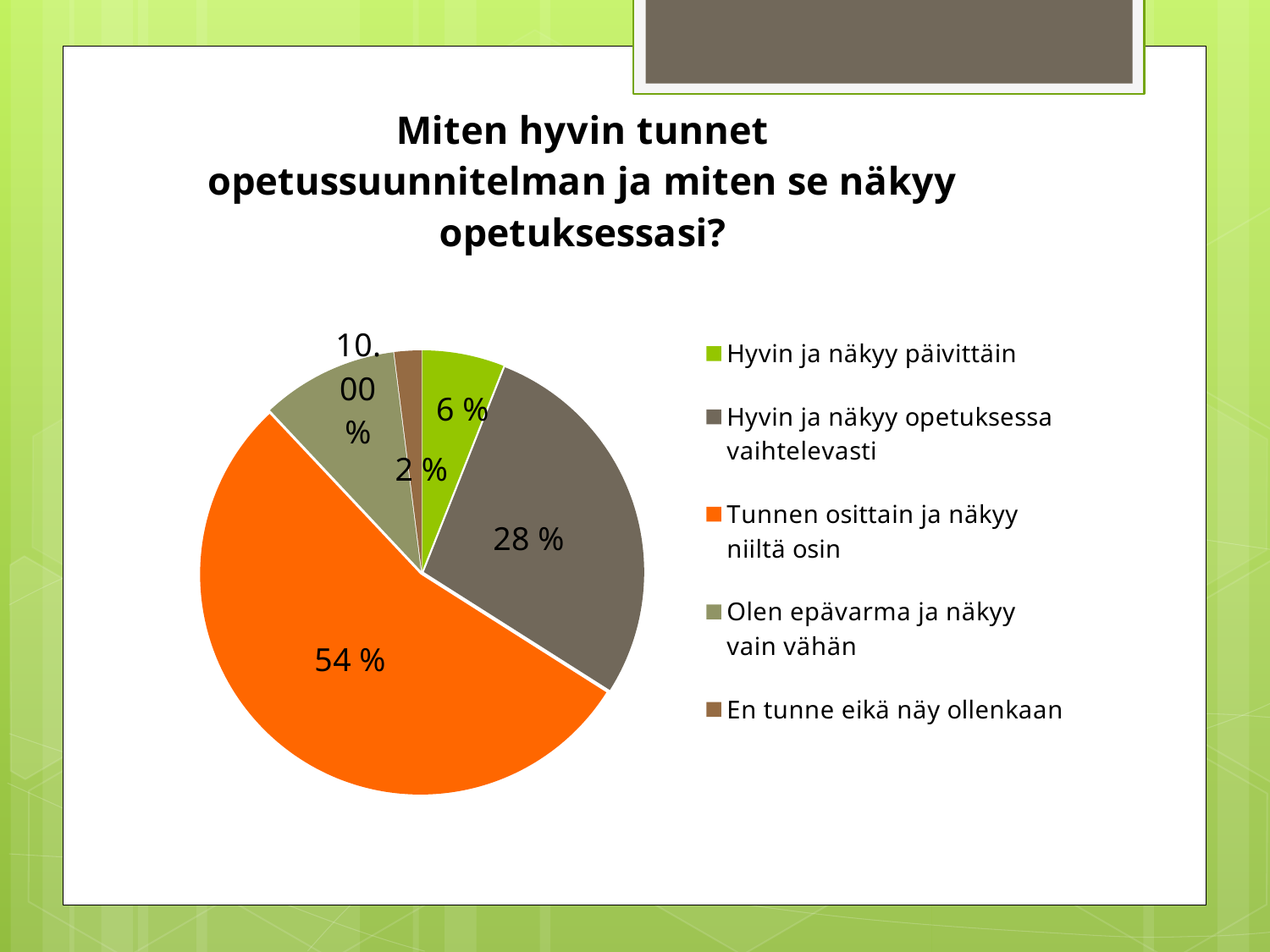
What share of the pie does "En tunne eikä näy ollenkaan" have? 2 % Which category has the smallest slice of the pie? En tunne eikä näy ollenkaan What colour is the slice for "Tunnen osittain ja näkyy niiltä osin"? Orange What is the difference in percentage points between "Tunnen osittain ja näkyy niiltä osin" and "Hyvin ja näkyy opetuksessa vaihtelevasti"? 26 percentage points How many categories does the legend list? 5 Which category has the largest slice of the pie? Tunnen osittain ja näkyy niiltä osin Which is larger: the slice for "Hyvin ja näkyy päivittäin" or the slice for "Hyvin ja näkyy opetuksessa vaihtelevasti"? Hyvin ja näkyy opetuksessa vaihtelevasti What share of the pie does "Tunnen osittain ja näkyy niiltä osin" have? 54 % What share of the pie does "Hyvin ja näkyy päivittäin" have? 6 % What share of the pie does "Hyvin ja näkyy opetuksessa vaihtelevasti" have? 28 % What is the title of the chart? Miten hyvin tunnet opetussuunnitelman ja miten se näkyy opetuksessasi? What kind of chart is shown on the slide? Pie chart